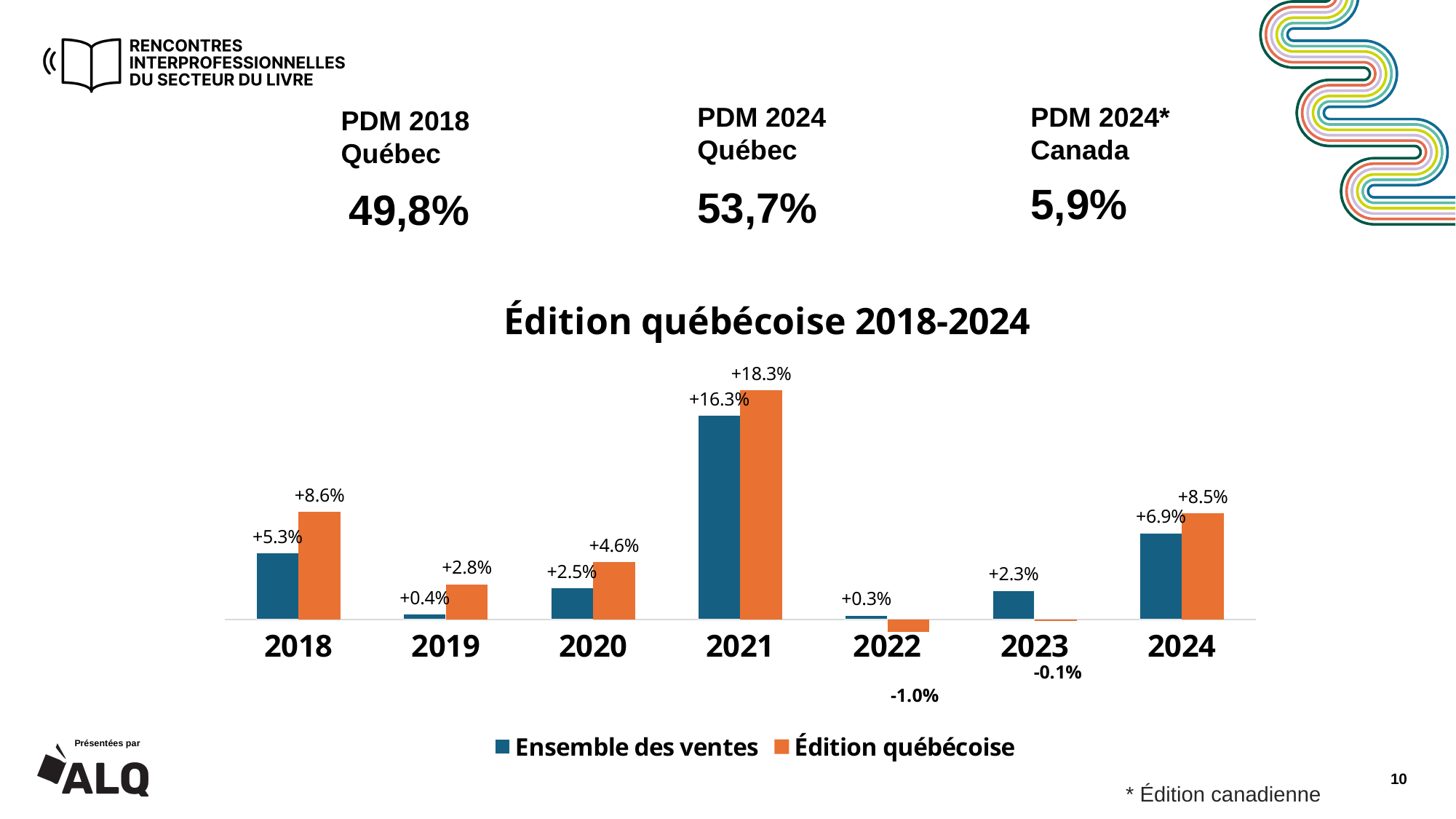
What is the value for Édition québécoise in 2022? -1.0% Which year has the highest value for Ensemble des ventes? 2021 Which year has the lowest value for Édition québécoise? 2022 In 2023, which series has the larger value: Ensemble des ventes or Édition québécoise? Ensemble des ventes What is the value for Édition québécoise in 2021? +18.3% What is the value for Ensemble des ventes in 2024? +6.9% How many years are shown on the x axis of the chart? 7 What is the difference between Édition québécoise and Ensemble des ventes in 2018? 3.3 percentage points What kind of chart is shown on the slide? Bar chart What is the title of the chart? Édition québécoise 2018-2024 How many series does the chart legend list? 2 What is the value for Ensemble des ventes in 2019? +0.4%